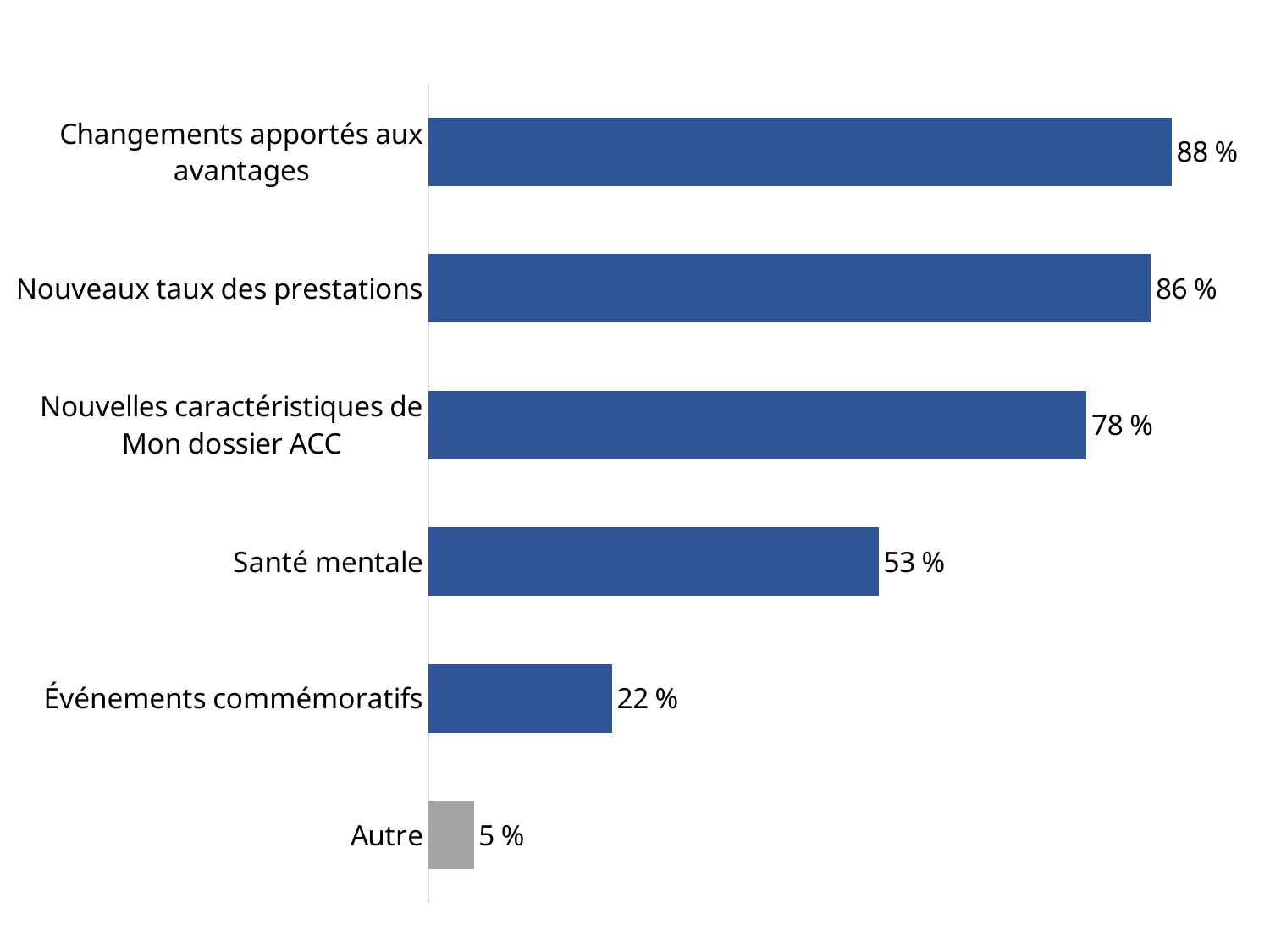
Which category has the lowest value? Autre What is the value for Santé mentale? 53 % What is the value for Autre? 5 % Which bar is coloured grey instead of blue? Autre What is the difference between Santé mentale and Événements commémoratifs? 31 % What is the difference between Nouveaux taux des prestations and Nouvelles caractéristiques de Mon dossier ACC? 8 % Which is larger, Nouvelles caractéristiques de Mon dossier ACC or Santé mentale? Nouvelles caractéristiques de Mon dossier ACC What kind of chart is this? bar chart What is the value for Changements apportés aux avantages? 88 % Which category has the highest value? Changements apportés aux avantages How many categories are shown in the chart? 6 What is the value for Événements commémoratifs? 22 %